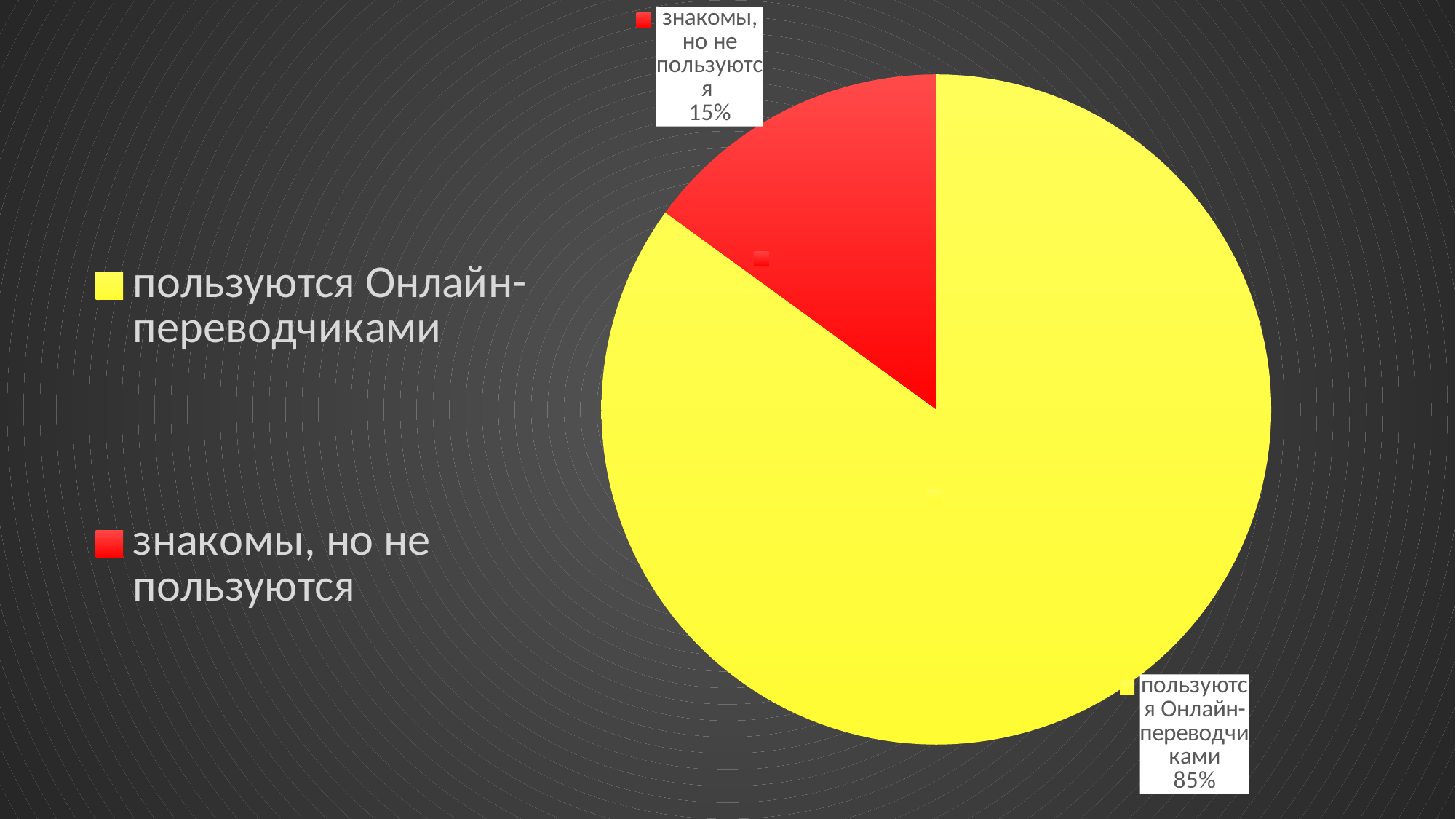
How many entries does the legend list? 2 What is the difference in percentage points between the "пользуются Онлайн-переводчиками" slice and the "знакомы, но не пользуются" slice? 70 What kind of chart is shown on the slide? pie chart How many slices does the pie chart have? 2 What colour is the slice for "пользуются Онлайн-переводчиками"? yellow Which category has the largest slice of the pie? пользуются Онлайн-переводчиками What share of the pie is labelled "пользуются Онлайн-переводчиками"? 85% What colour is the slice for "знакомы, но не пользуются"? red Which is larger: the share for "пользуются Онлайн-переводчиками" or the share for "знакомы, но не пользуются"? пользуются Онлайн-переводчиками Which category has the smallest slice of the pie? знакомы, но не пользуются What share of the pie is labelled "знакомы, но не пользуются"? 15%